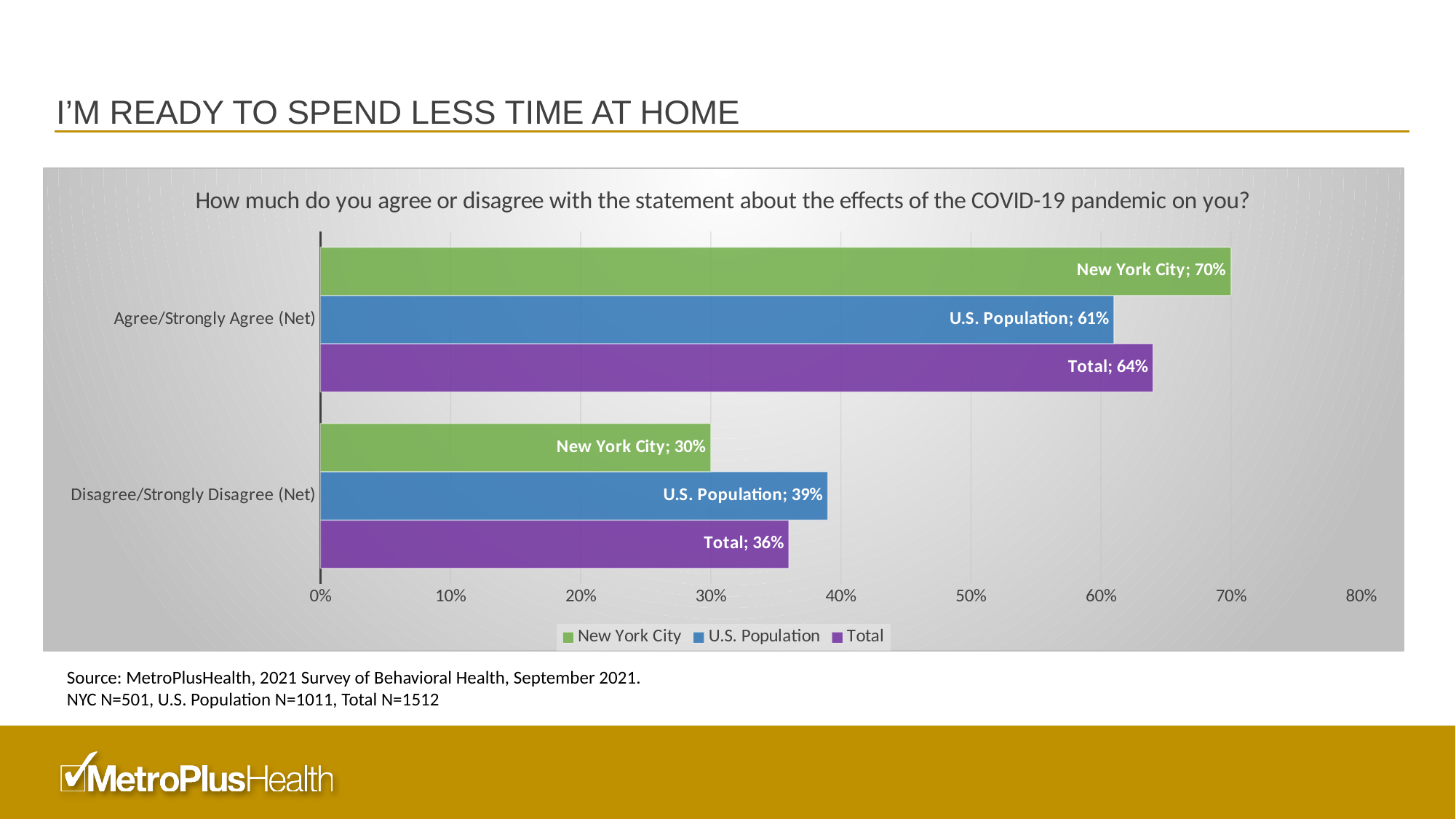
What kind of chart is shown on the slide? Bar chart What colour represents the Total series in the chart? Purple Which series has the highest value for Agree/Strongly Agree (Net)? New York City What percentage of New York City respondents agree or strongly agree (net) with the statement? 70% How many categories are shown on the vertical axis of the chart? 2 What is the difference between the New York City and U.S. Population values for Agree/Strongly Agree (Net)? 9% What is the Total value for Agree/Strongly Agree (Net)? 64% How many series does the legend list? 3 Which series has the lowest value for Disagree/Strongly Disagree (Net)? New York City What is the difference between the U.S. Population and Total values for Disagree/Strongly Disagree (Net)? 3% What is the U.S. Population value for Disagree/Strongly Disagree (Net)? 39% Which is larger: the Total value for Agree/Strongly Agree (Net) or the Total value for Disagree/Strongly Disagree (Net)? Agree/Strongly Agree (Net)